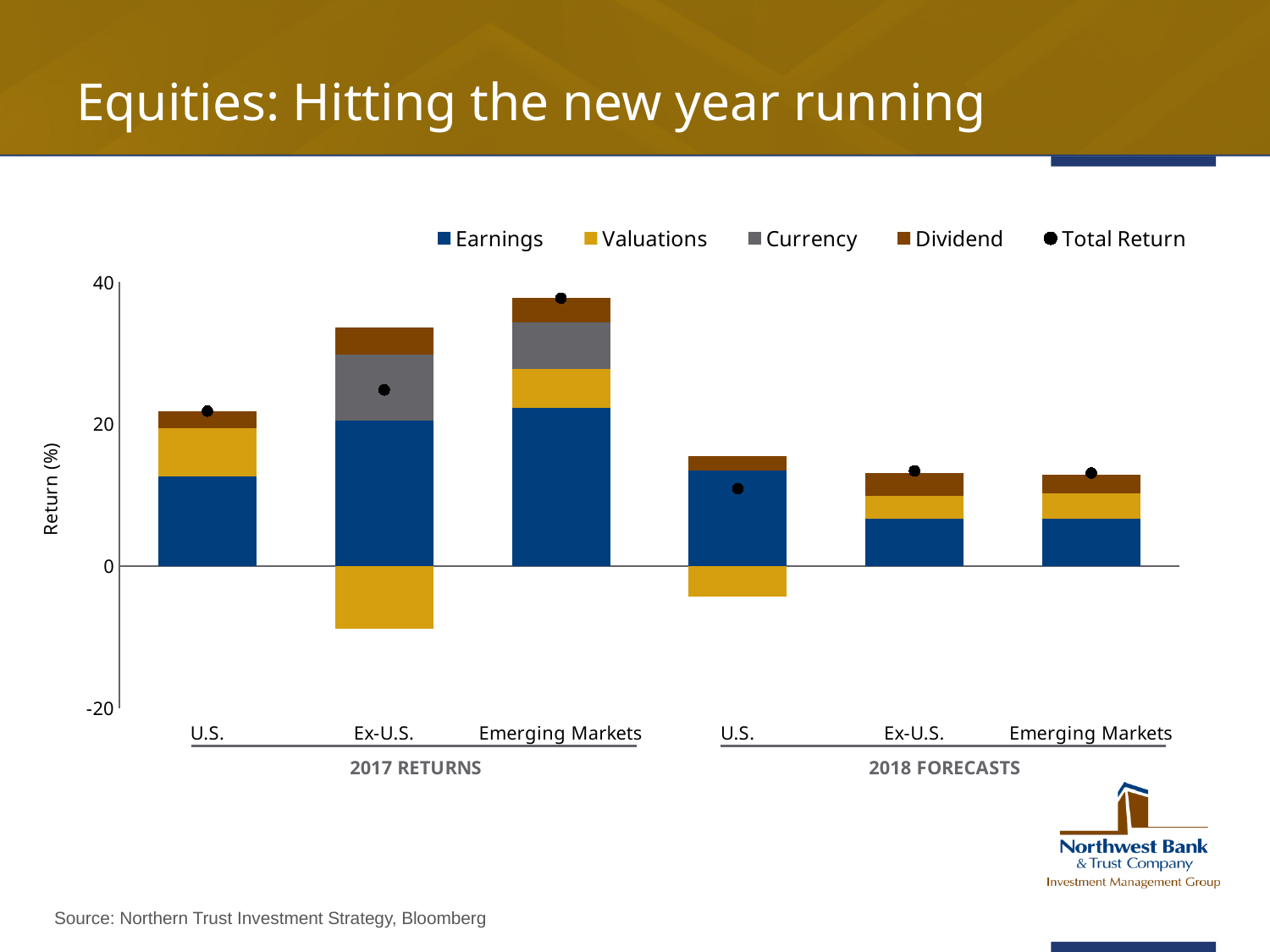
Is the Total Return for U.S. in 2018 Forecasts greater or less than 20? less What is the label on the vertical axis? Return (%) Which is larger, the Total Return for Emerging Markets in 2017 Returns or in 2018 Forecasts? 2017 Returns How many bars are plotted in the chart? 6 Is the Valuations value for Ex-U.S. in 2017 Returns greater or less than 0? less Across the 2017 Returns bars from U.S. to Emerging Markets, does the Total Return rise or fall? Rise How many series does the legend list? 5 Which bar has the highest Total Return? Emerging Markets (2017 Returns) Which is larger, the Total Return for U.S. or Ex-U.S. in 2017 Returns? Ex-U.S. What kind of chart is shown on the slide? Stacked bar chart Is the Total Return for Emerging Markets in 2017 Returns greater or less than 20? greater